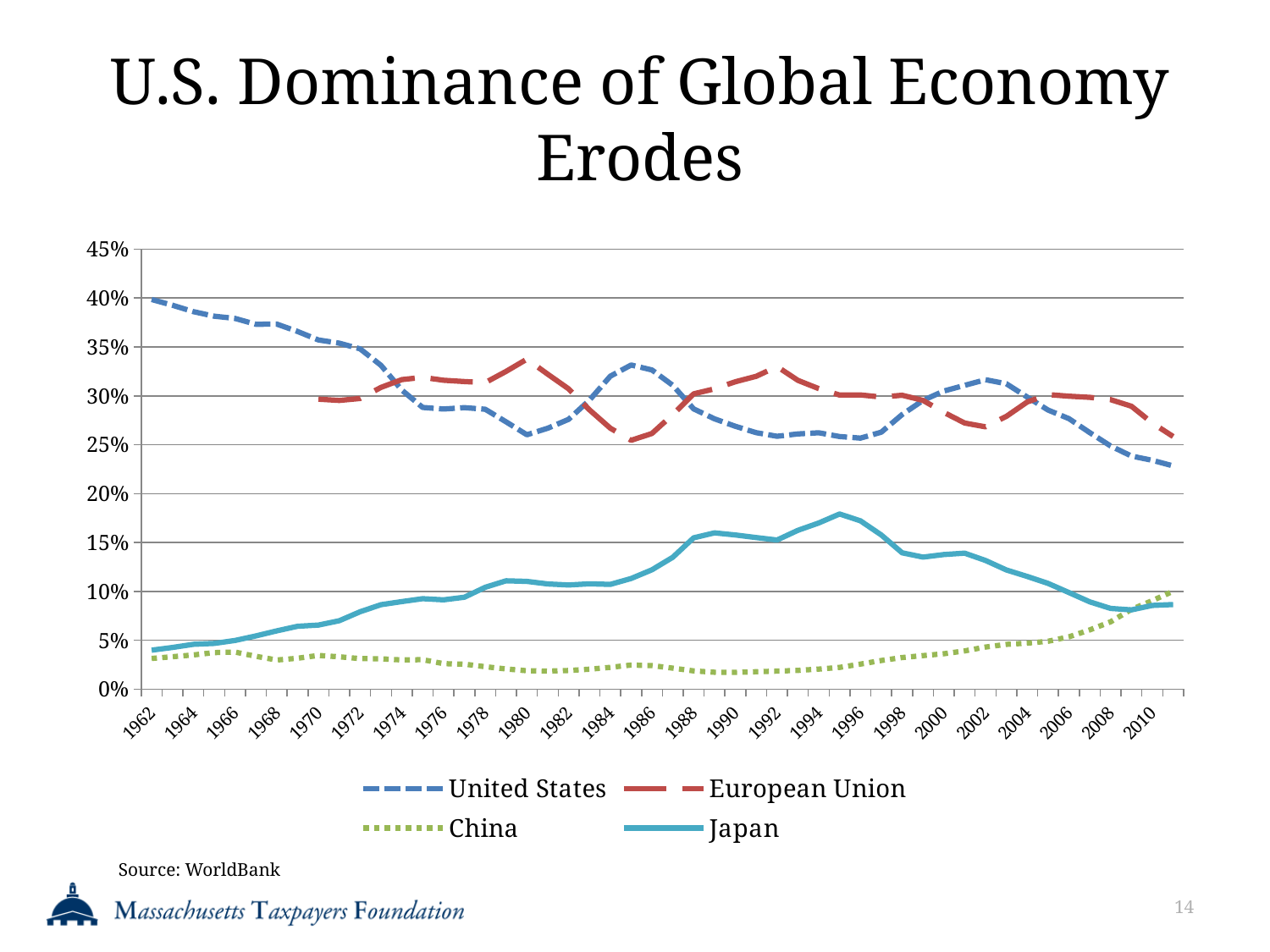
Which series has the highest value in 1962? United States Does the United States line generally rise or fall from 1962 to 2010? fall Is the value for European Union in 1980 greater or less than 30%? greater How many series does the legend list? 4 What source is cited for the chart? WorldBank Is the value for China in 1990 greater or less than 5%? less What kind of chart is shown on the slide? line chart Is the value for United States in 1962 greater or less than 35%? greater How many year labels are shown on the x axis? 25 Which series has the lowest value in 1990? China In 2010, which is larger, the value for United States or the value for China? United States What is the title of the chart on the slide? U.S. Dominance of Global Economy Erodes